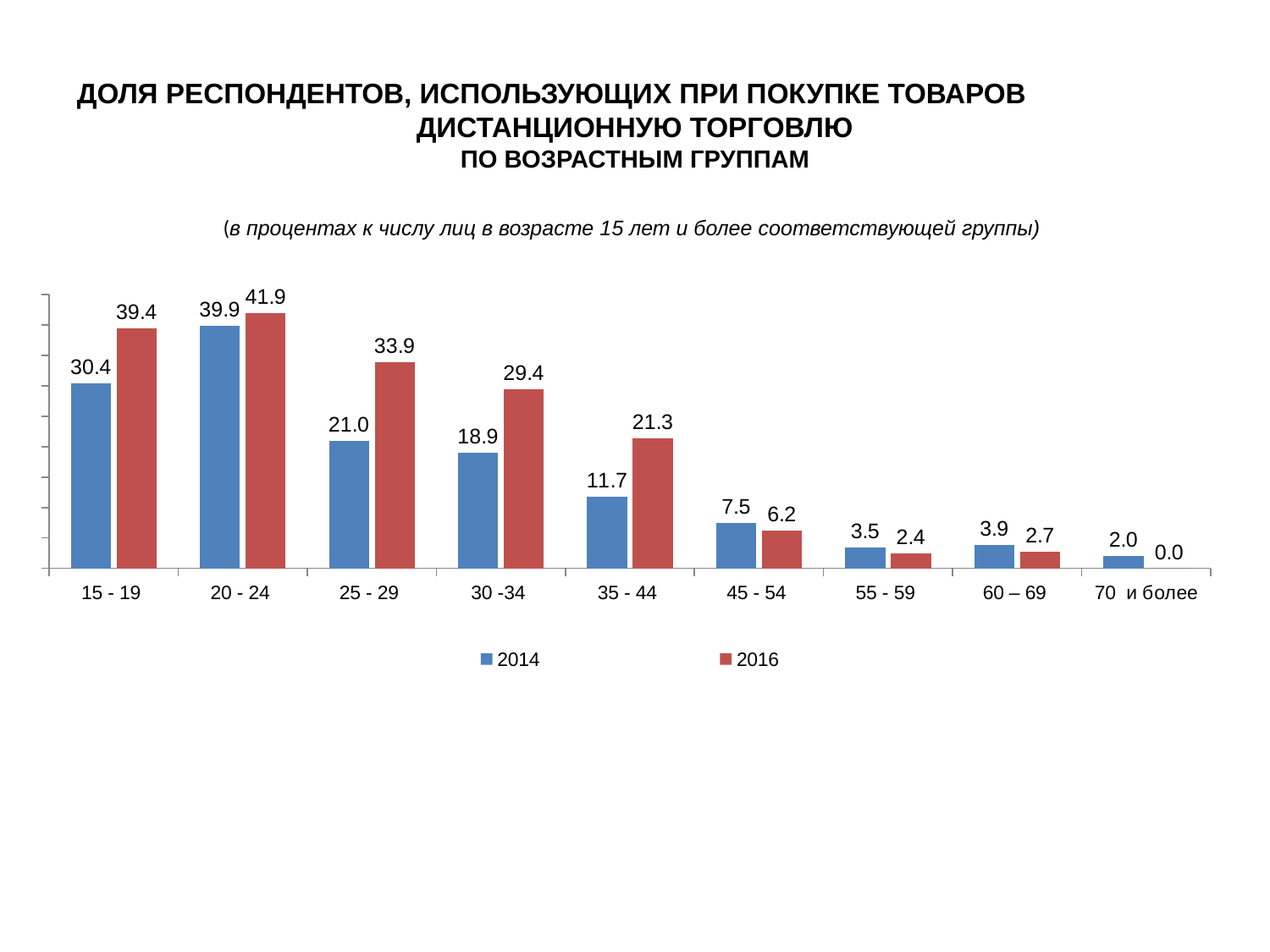
What is the difference between the 2016 and 2014 values for the 25 - 29 age group? 12.9 What is the value for the 35 - 44 age group in 2014? 11.7 What is the value for the 15 - 19 age group in 2016? 39.4 What is the value for the 70 и более age group in 2016? 0.0 Which age group has the highest value in the 2016 series? 20 - 24 Which is larger for the 30 -34 age group: the 2014 value or the 2016 value? 2016 What is the difference between the 2014 and 2016 values for the 45 - 54 age group? 1.3 How many series does the legend list? 2 How many age groups are shown on the x axis? 9 What kind of chart is shown on the slide? Bar chart Which is larger for the 60 – 69 age group: the 2014 value or the 2016 value? 2014 Which age group has the lowest value in the 2014 series? 70 и более